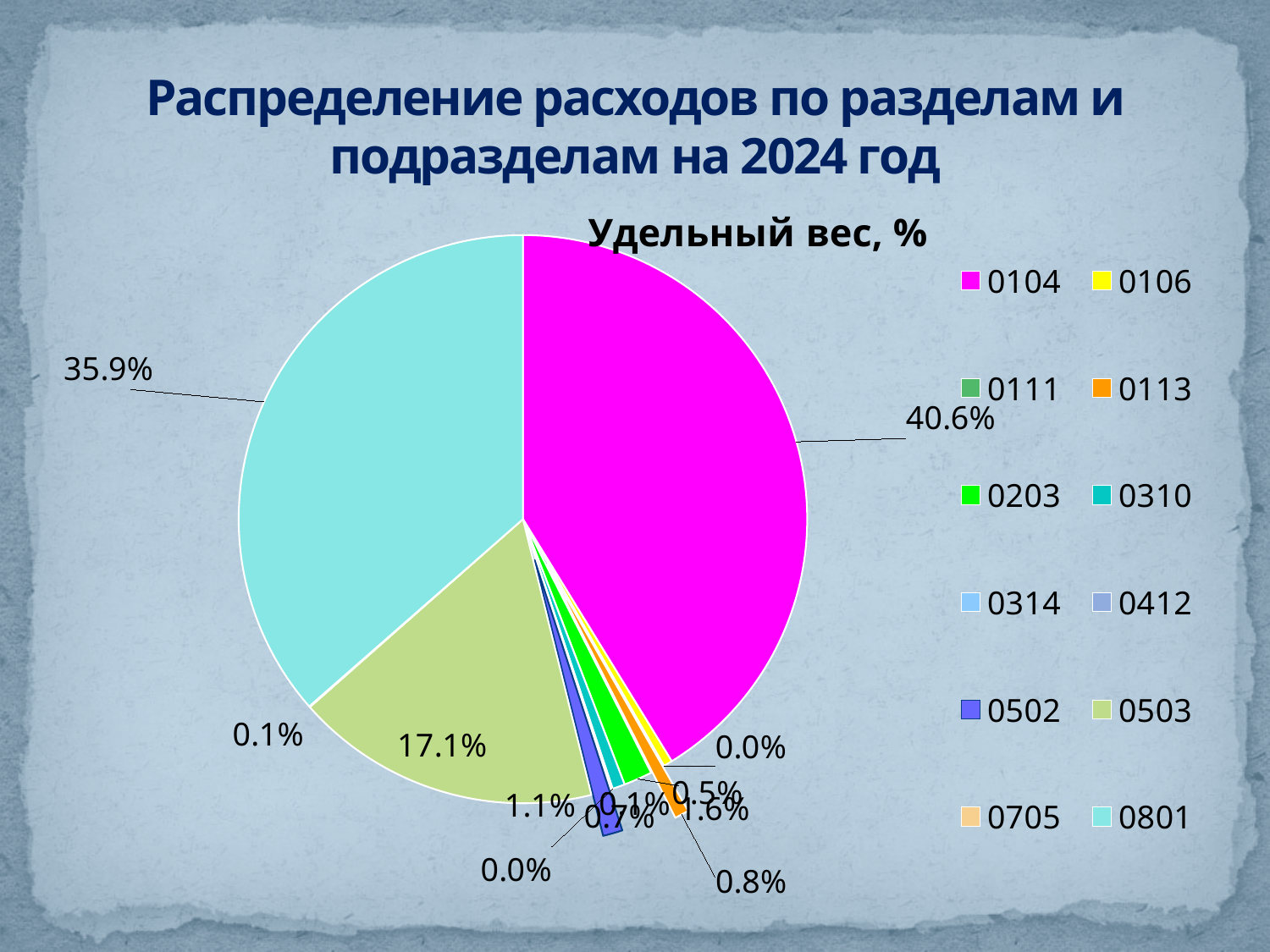
Which category has the largest slice of the pie? 0104 What is the difference between the values for 0104 and 0801? 4.7% What is the combined share of the three largest slices (0104, 0801 and 0503)? 93.6% What share of the pie does category 0104 take? 40.6% What is the difference between the values for 0801 and 0503? 18.8% What is the value shown for category 0503? 17.1% What is the title of the chart? Удельный вес, % What is the value shown for category 0801? 35.9% How many categories does the legend list? 12 Which is larger, the slice for 0104 or the slice for 0801? 0104 What type of chart is shown on the slide? pie chart What colour is the slice for category 0104? magenta